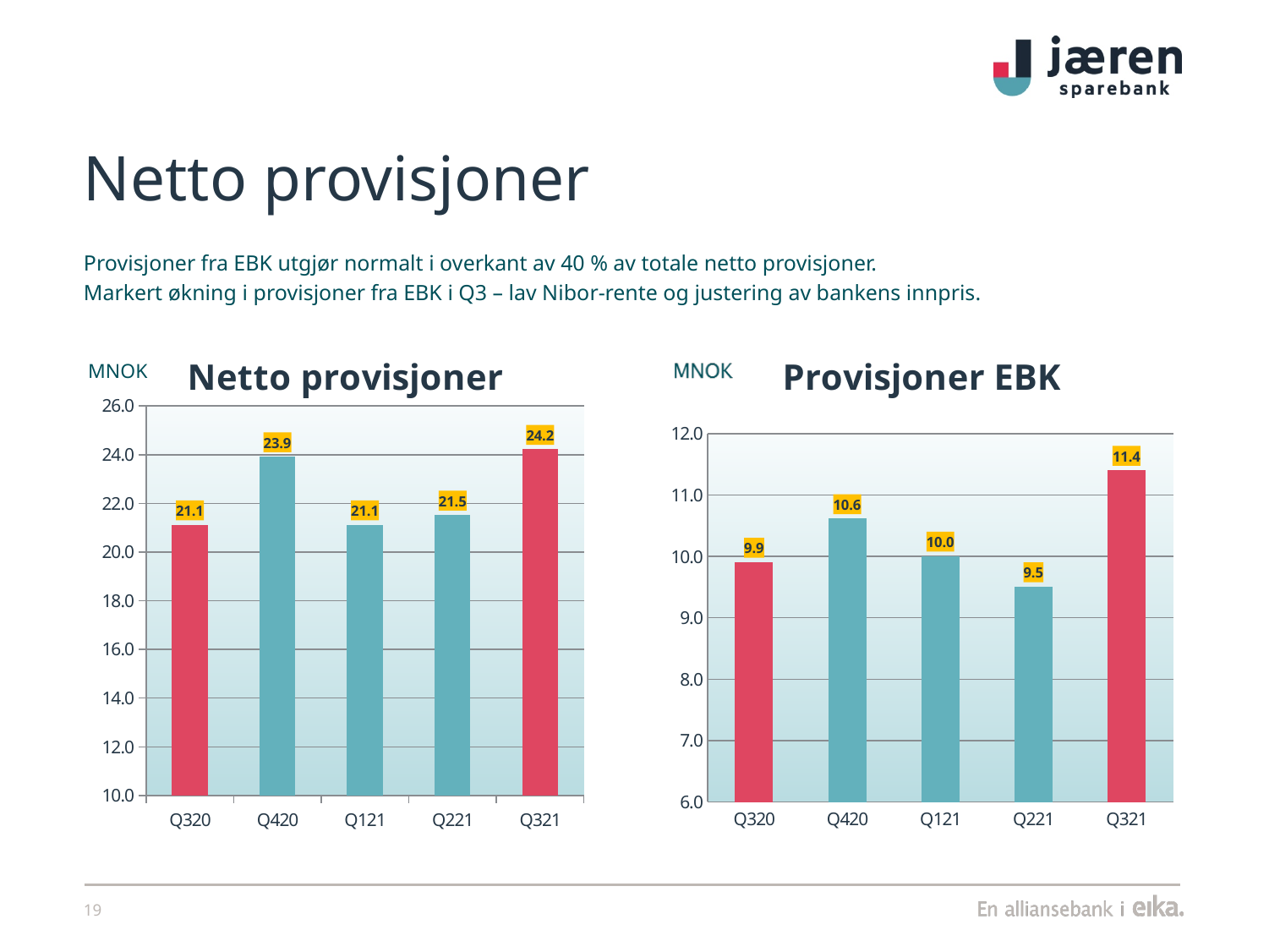
In the 'Provisjoner EBK' chart, which quarter has the lowest value? Q221 In the 'Provisjoner EBK' chart, what is the value for Q320? 9.9 In the 'Provisjoner EBK' chart, which is larger, Q420 or Q121? Q420 In the 'Netto provisjoner' chart, what is the difference between Q321 and Q121? 3.1 In the 'Netto provisjoner' chart, what is the value for Q420? 23.9 In the 'Netto provisjoner' chart, what unit is shown above the y axis? MNOK In the 'Netto provisjoner' chart, which quarter has the highest value? Q321 In the 'Netto provisjoner' chart, what is the value for Q321? 24.2 What type of chart is the 'Netto provisjoner' chart? Bar chart In the 'Provisjoner EBK' chart, what is the difference between Q321 and Q221? 1.9 How many quarters are shown in the 'Provisjoner EBK' chart? 5 In the 'Provisjoner EBK' chart, what is the value for Q221? 9.5